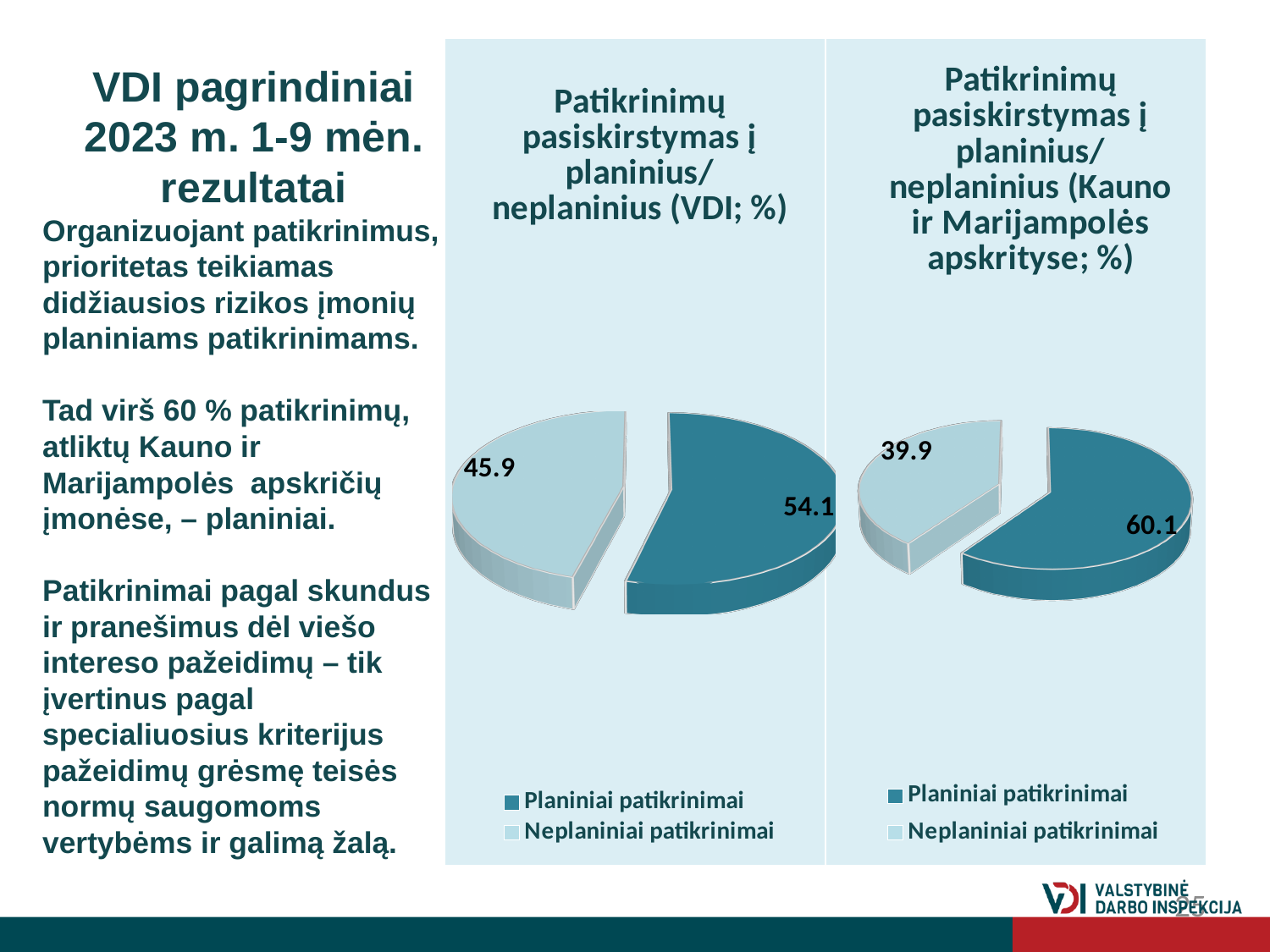
In the left chart (VDI; %), what is the value for Neplaniniai patikrinimai? 45.9 In the right chart (Kauno ir Marijampolės apskrityse; %), what is the value for Planiniai patikrinimai? 60.1 In the right chart (Kauno ir Marijampolės apskrityse; %), what is the difference between Planiniai patikrinimai and Neplaniniai patikrinimai? 20.2 In the right chart (Kauno ir Marijampolės apskrityse; %), what is the value for Neplaniniai patikrinimai? 39.9 In the left chart (VDI; %), what is the difference between Planiniai patikrinimai and Neplaniniai patikrinimai? 8.2 Which is larger: Planiniai patikrinimai in the left chart (VDI) or Planiniai patikrinimai in the right chart (Kauno ir Marijampolės apskrityse)? Right chart (Kauno ir Marijampolės apskrityse) In the right chart (Kauno ir Marijampolės apskrityse; %), which category has the smallest slice? Neplaniniai patikrinimai In the left chart (VDI; %), what is the value for Planiniai patikrinimai? 54.1 In the left chart (VDI; %), which category has the largest slice? Planiniai patikrinimai What are the two legend entries of the left chart (VDI; %)? Planiniai patikrinimai, Neplaniniai patikrinimai What type of chart is used on the left (VDI; %)? Pie chart How many categories does the right chart (Kauno ir Marijampolės apskrityse; %) show? 2